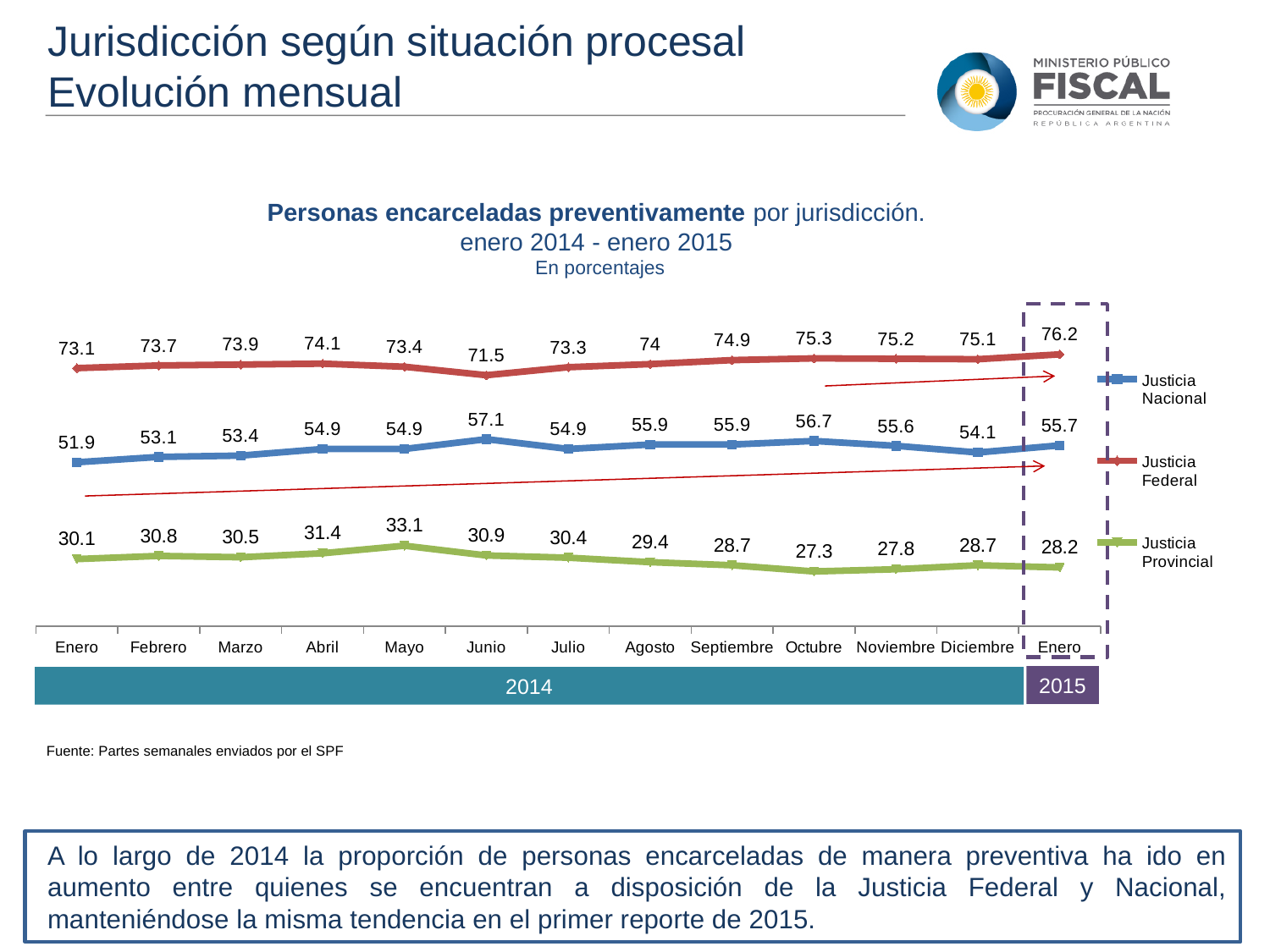
Which series is drawn in green? Justicia Provincial Does the Justicia Provincial series generally rise or fall from Mayo to Octubre? Fall How many months are plotted along the x axis? 13 In which month does Justicia Nacional reach its highest value? Junio What is the value for Justicia Provincial in Mayo? 33.1 Which series has the higher value in Diciembre, Justicia Nacional or Justicia Provincial? Justicia Nacional How many series does the legend list? 3 What is the value for Justicia Federal in Junio? 71.5 What is the difference between the Justicia Federal values in Enero 2015 and Enero 2014? 3.1 What type of chart is shown on the slide? Line chart What is the value for Justicia Nacional in Enero 2015? 55.7 In which month does Justicia Provincial reach its lowest value? Octubre